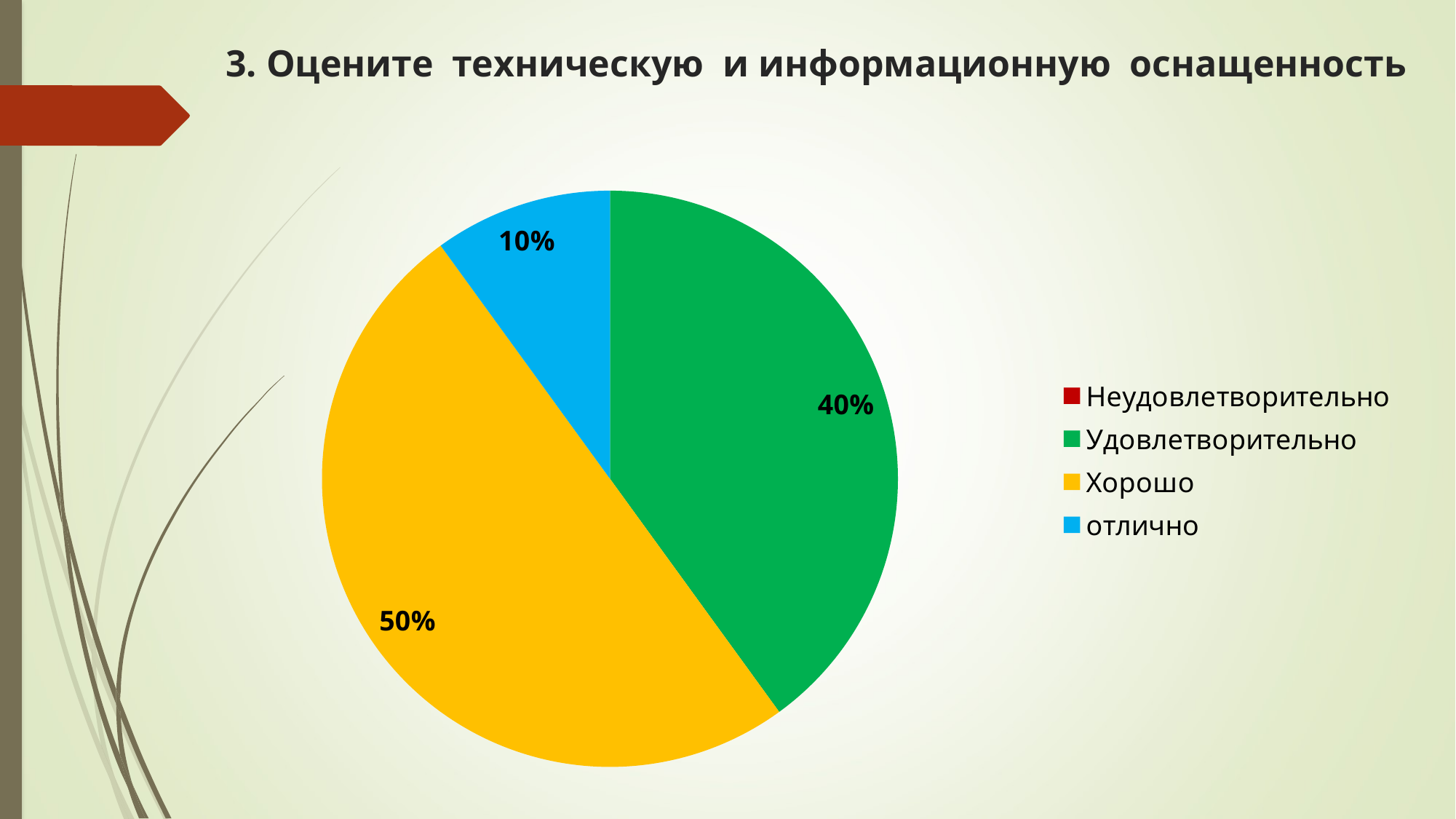
What colour is the slice for Хорошо? yellow What share of the pie is labelled for Удовлетворительно? 40% How many entries does the legend list? 4 What share of the pie is labelled for Хорошо? 50% What share of the pie is labelled for отлично? 10% Which labelled slice of the pie is the smallest? отлично What is the difference in percentage points between the Хорошо and Удовлетворительно slices? 10% What kind of chart is shown on the slide? pie chart What is the difference in percentage points between the Удовлетворительно and отлично slices? 30% What is the title of the slide containing the pie chart? 3. Оцените техническую и информационную оснащенность Which slice is larger, Удовлетворительно or отлично? Удовлетворительно Which category has the largest slice of the pie? Хорошо